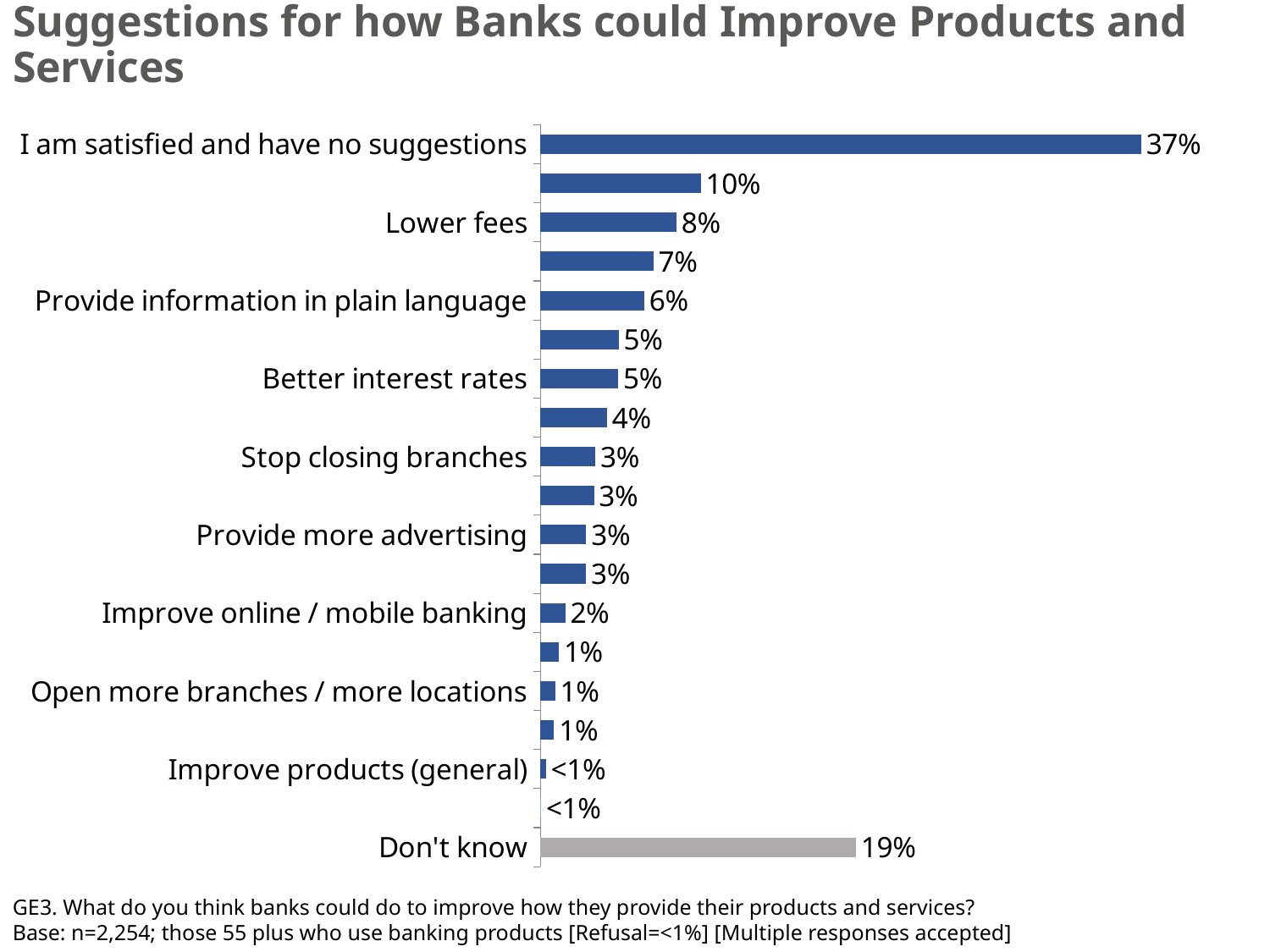
Which bar is shown in grey rather than blue? Don't know What is the value for "Provide information in plain language"? 6% Which category has the highest value in the chart? I am satisfied and have no suggestions Which is larger, the value for "Lower fees" or the value for "Provide information in plain language"? Lower fees What is the difference in percentage points between "Lower fees" and "Better interest rates"? 3 percentage points What is the value for "Improve online / mobile banking"? 2% What is the difference in percentage points between "I am satisfied and have no suggestions" and "Don't know"? 18 percentage points What kind of chart is shown on the slide? Bar chart What is the value for "Don't know"? 19% What is the value for "Better interest rates"? 5% What is the value for "Lower fees"? 8% What percentage of respondents said they are satisfied and have no suggestions? 37%